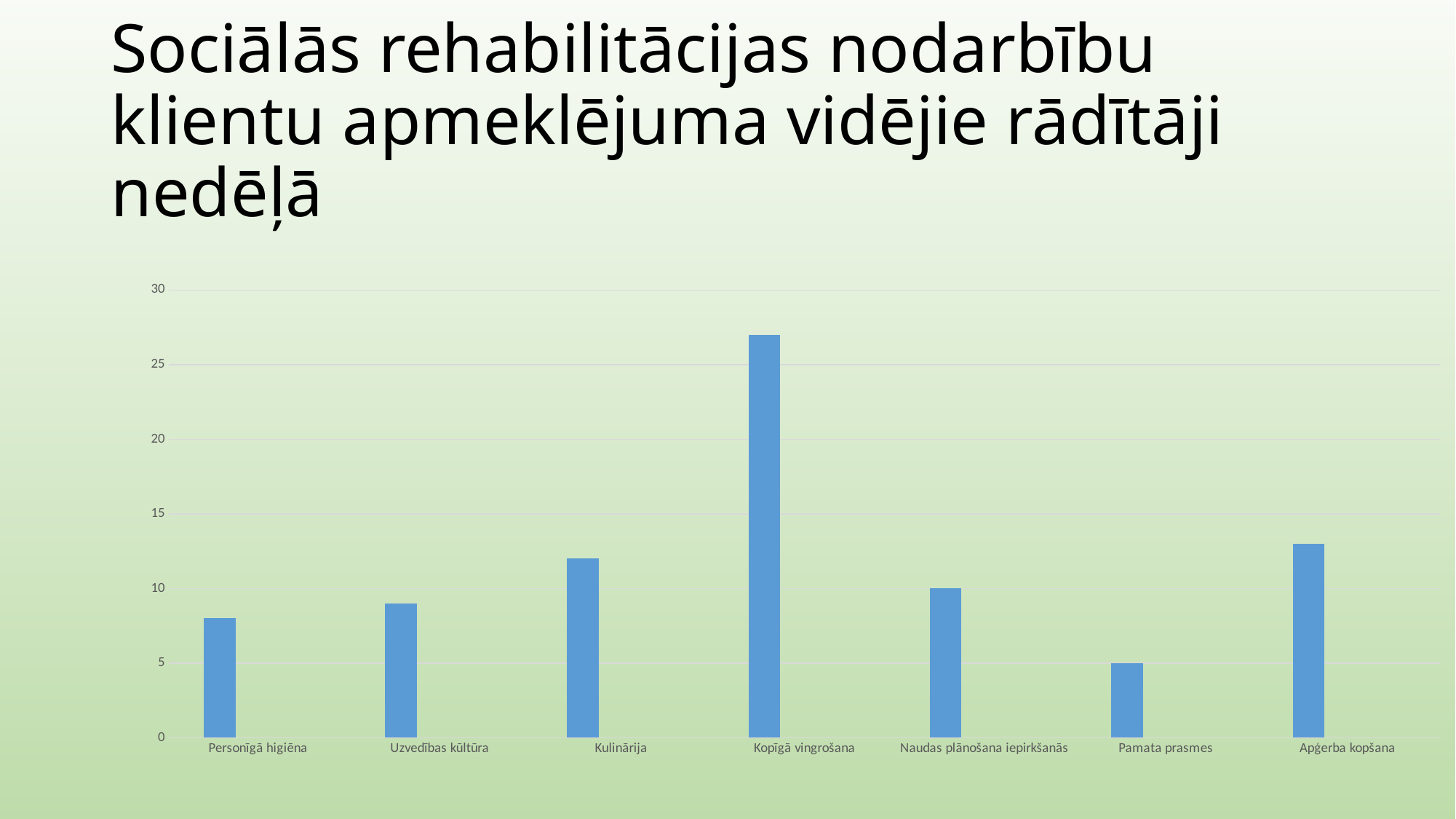
How many categories are shown on the x axis of the chart? 7 Is the value for Kopīgā vingrošana greater or less than 25? greater What kind of chart is shown on the slide? bar chart Is the value for Kulinārija greater or less than 10? greater What is the value for Pamata prasmes? 5 Which is larger, the value for Apģerba kopšana or the value for Naudas plānošana iepirkšanās? Apģerba kopšana Which is larger, the value for Kopīgā vingrošana or the value for Kulinārija? Kopīgā vingrošana What is the value for Naudas plānošana iepirkšanās? 10 Which category has the lowest value in the chart? Pamata prasmes Is the value for Personīgā higiēna greater or less than 10? less Which category has the highest value in the chart? Kopīgā vingrošana